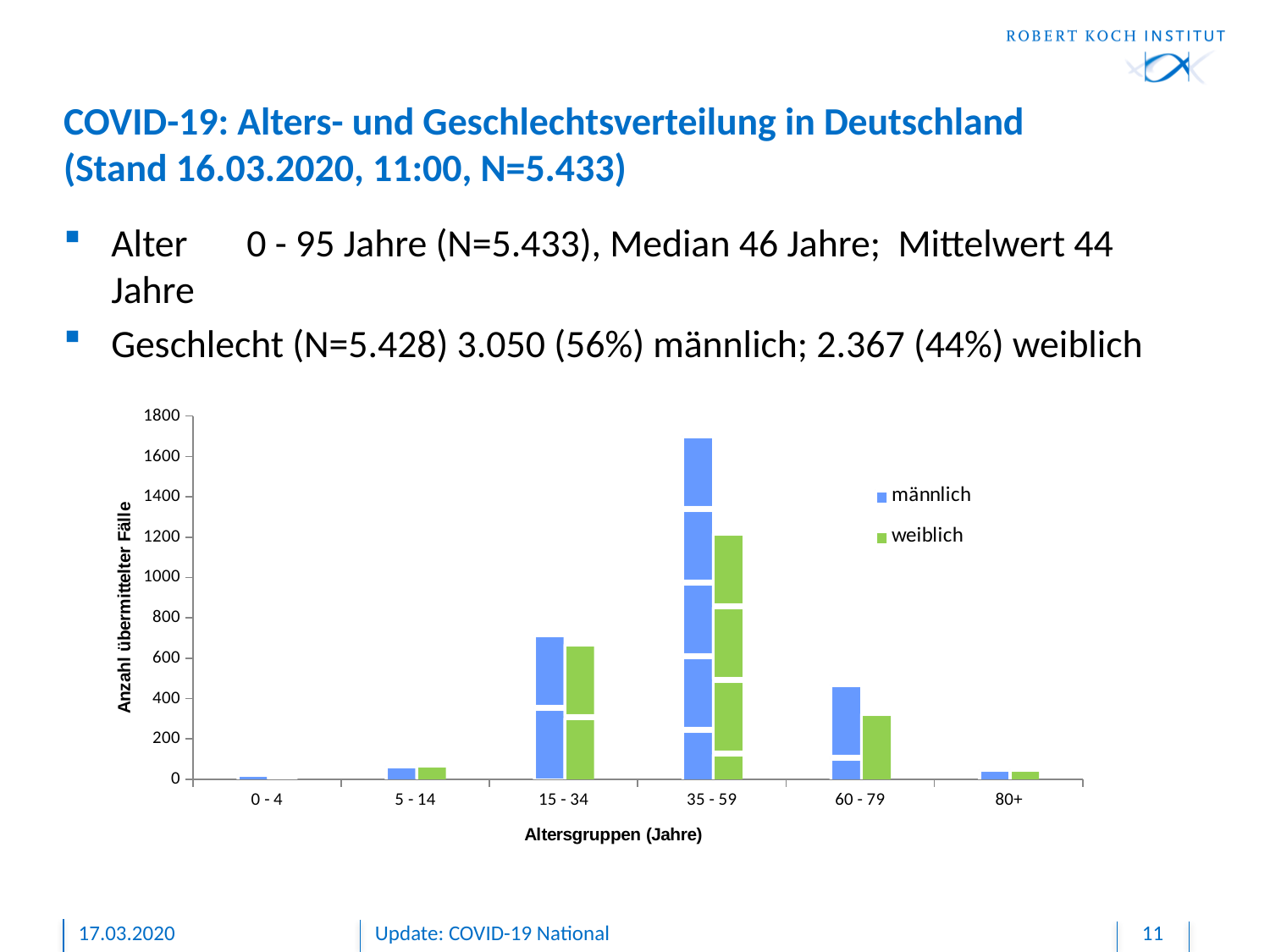
What kind of chart is shown on the slide? bar chart What is the title of the y axis? Anzahl übermittelter Fälle Is the value for männlich in the 35 - 59 age group greater or less than 1400? greater In the 60 - 79 age group, which series has the larger value, männlich or weiblich? männlich Is the value for weiblich in the 35 - 59 age group greater or less than 1000? greater Which age group has the highest number of cases for weiblich? 35 - 59 Is the value for männlich in the 60 - 79 age group greater or less than 600? less Which age group has the lowest number of cases for männlich? 0 - 4 How many age groups are shown on the x axis? 6 How many series does the legend list? 2 Which age group has the highest number of cases for männlich? 35 - 59